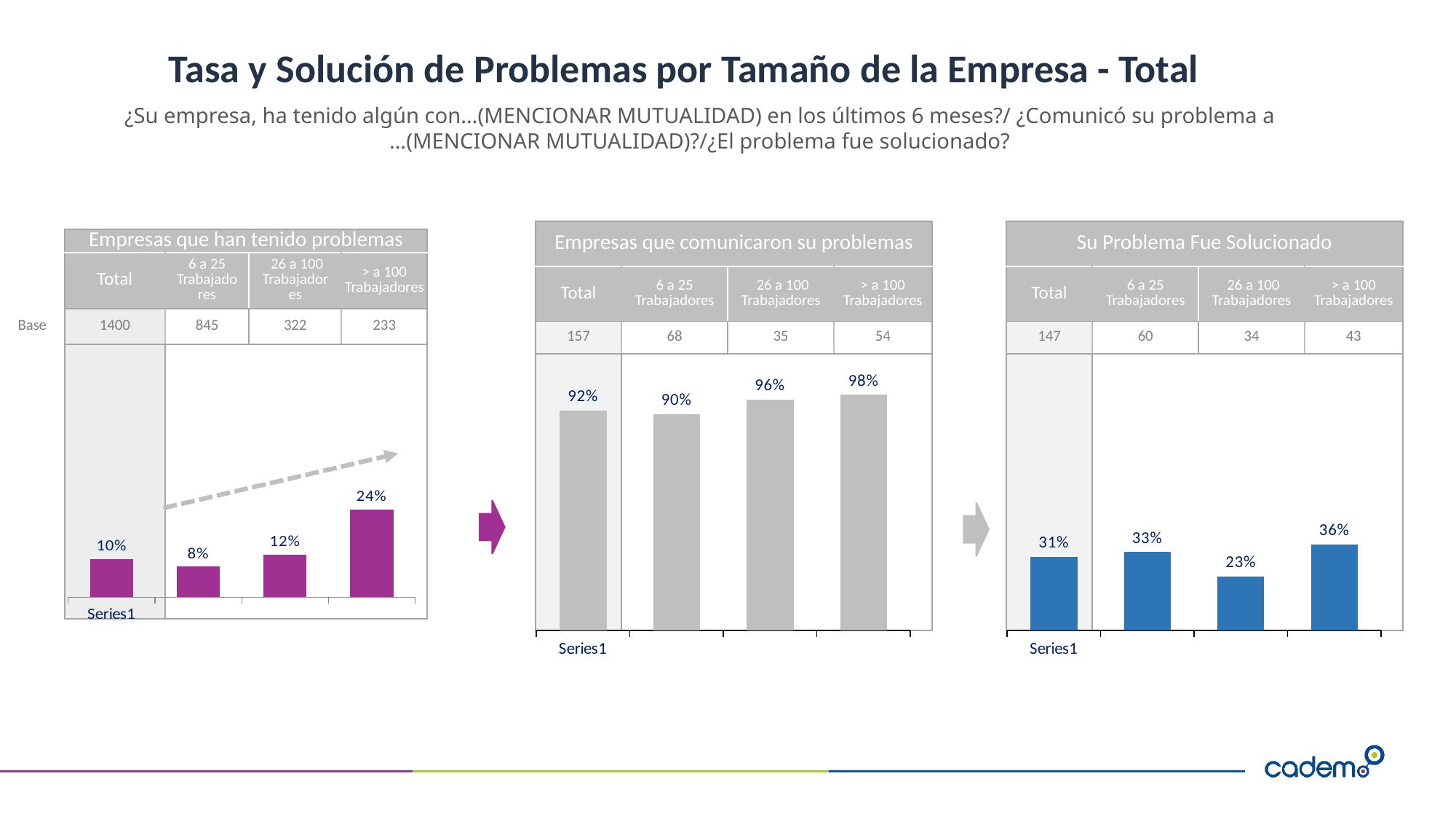
How many bars are plotted in the 'Su Problema Fue Solucionado' chart? 4 In the 'Empresas que comunicaron su problemas' chart, what is the value for 26 a 100 Trabajadores? 96% In the 'Su Problema Fue Solucionado' chart, which is larger, the value for Total or the value for 6 a 25 Trabajadores? 6 a 25 Trabajadores In the 'Empresas que han tenido problemas' chart, which category has the lowest value? 6 a 25 Trabajadores In the 'Empresas que comunicaron su problemas' chart, what is the base (number of respondents) for Total? 157 In the 'Empresas que han tenido problemas' chart, what is the difference between the values for > a 100 Trabajadores and 6 a 25 Trabajadores? 16% In the 'Empresas que han tenido problemas' chart, which category has the highest value? > a 100 Trabajadores In the 'Empresas que han tenido problemas' chart, what is the value for Total? 10% What kind of chart is the 'Empresas que comunicaron su problemas' chart? Bar chart In the 'Su Problema Fue Solucionado' chart, what is the value for 26 a 100 Trabajadores? 23% In the 'Empresas que comunicaron su problemas' chart, which category has the lowest value? 6 a 25 Trabajadores In the 'Su Problema Fue Solucionado' chart, which category has the highest value? > a 100 Trabajadores